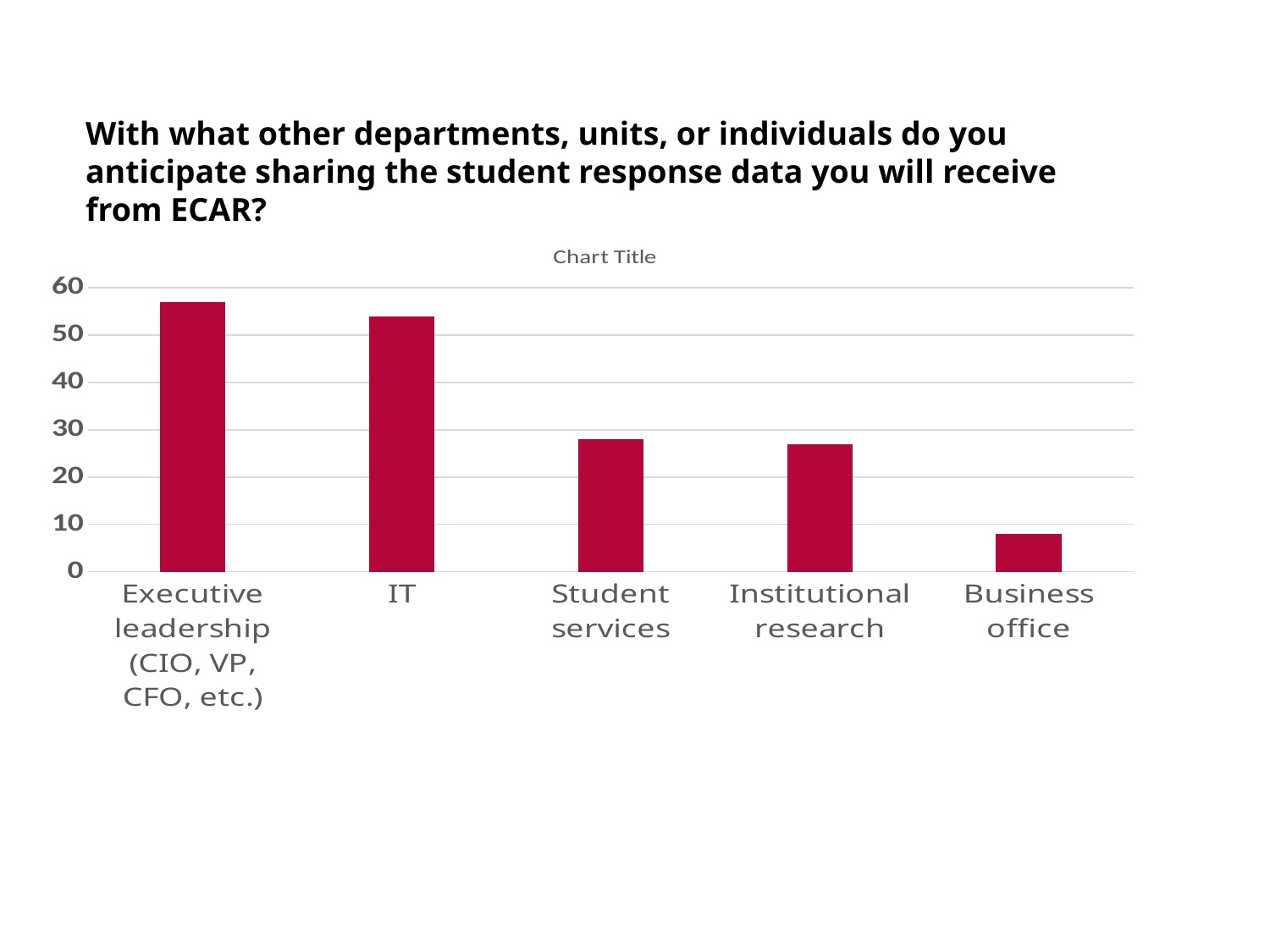
Which is larger, the value for IT or the value for Student services? IT What kind of chart is shown on the slide? bar chart How many categories are shown on the x axis of the chart? 5 Is the value for Executive leadership (CIO, VP, CFO, etc.) greater or less than 50? greater Is the value for Student services greater or less than 30? less Is the value for IT greater or less than 50? greater What is the title shown above the chart? Chart Title Do the values rise or fall moving from left to right along the x axis? fall Which category has the highest value in the chart? Executive leadership (CIO, VP, CFO, etc.) Which category has the lowest value in the chart? Business office